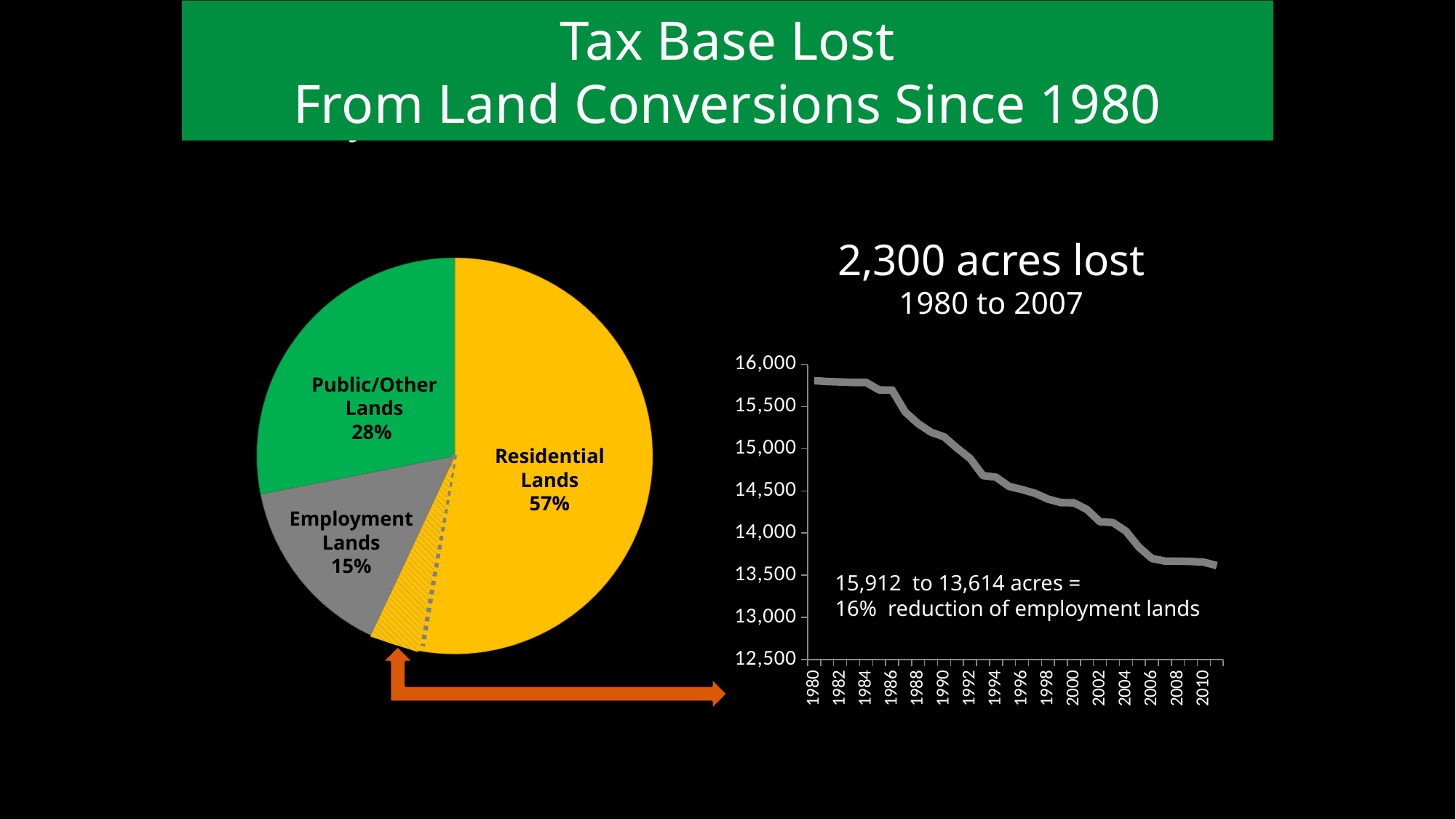
In the pie chart on the left, what share is labelled for Employment Lands? 15% In the line chart on the right, which year has the larger value, 1990 or 2000? 1990 What kind of chart is the chart on the right of the slide (under '2,300 acres lost')? Line chart In the line chart on the right, do the values rise or fall from 1980 to 2010? Fall In the pie chart on the left, what share is labelled for Residential Lands? 57% In the line chart on the right, is the value for 1980 greater or less than 15,500? greater In the pie chart on the left, what share is labelled for Public/Other Lands? 28% In the line chart on the right, is the value for 2010 greater or less than 14,000? less In the pie chart on the left, which category has the largest slice? Residential Lands In the pie chart on the left, which category has the smallest slice? Employment Lands In the pie chart on the left, how many slices are there? 3 In the pie chart on the left, by how many percentage points does Residential Lands exceed Public/Other Lands? 29 percentage points